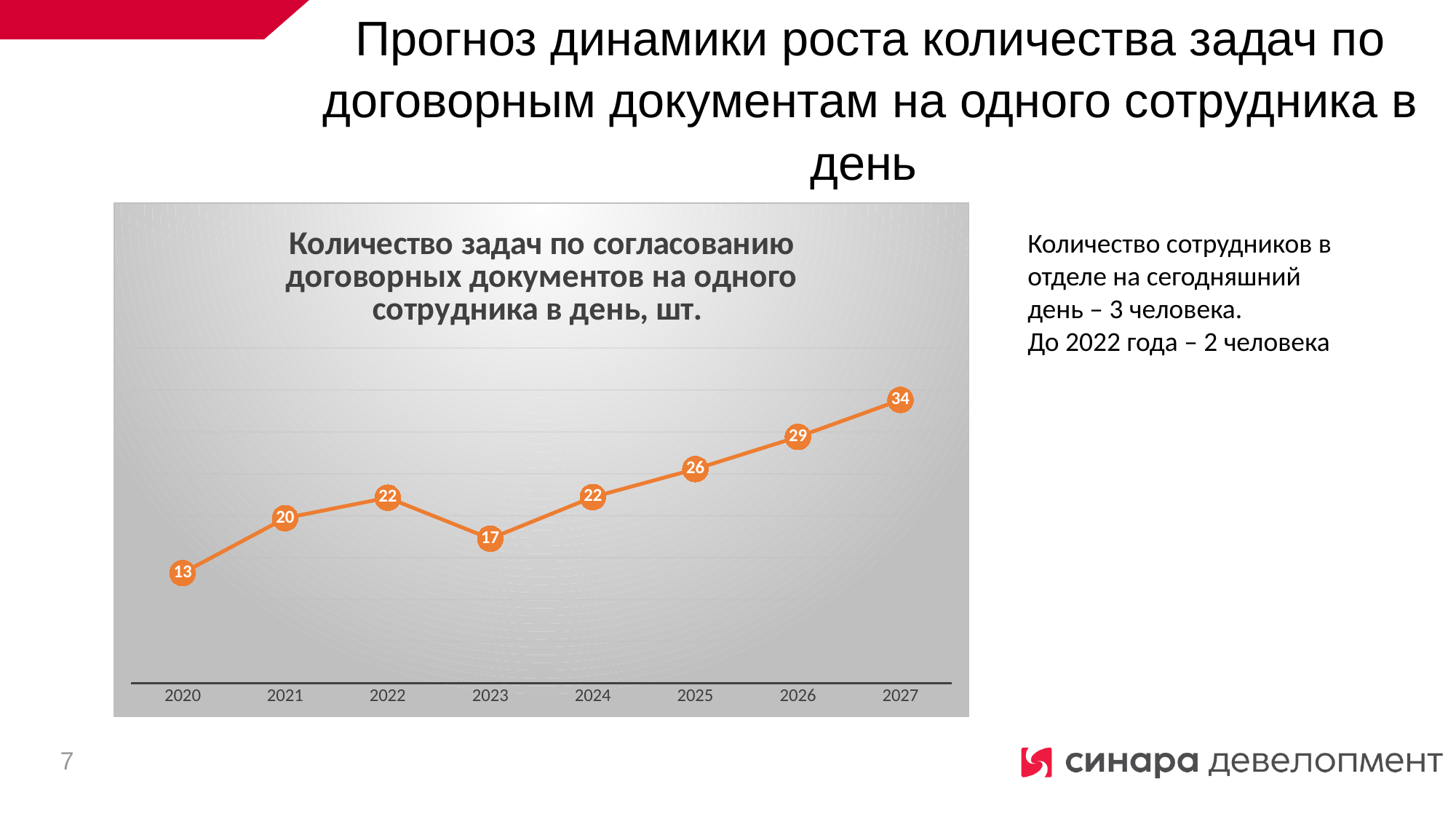
What kind of chart is shown? line chart How many years are plotted on the x axis? 8 Which year has the highest value? 2027 Do the values rise or fall from 2023 to 2027? rise What is the title of the chart? Количество задач по согласованию договорных документов на одного сотрудника в день, шт. What is the difference between the values for 2027 and 2020? 21 What is the value for 2027? 34 What is the value for 2020? 13 Which is larger, the value for 2022 or the value for 2023? 2022 Which year has the lowest value? 2020 What is the difference between the values for 2022 and 2023? 5 What is the value for 2023? 17